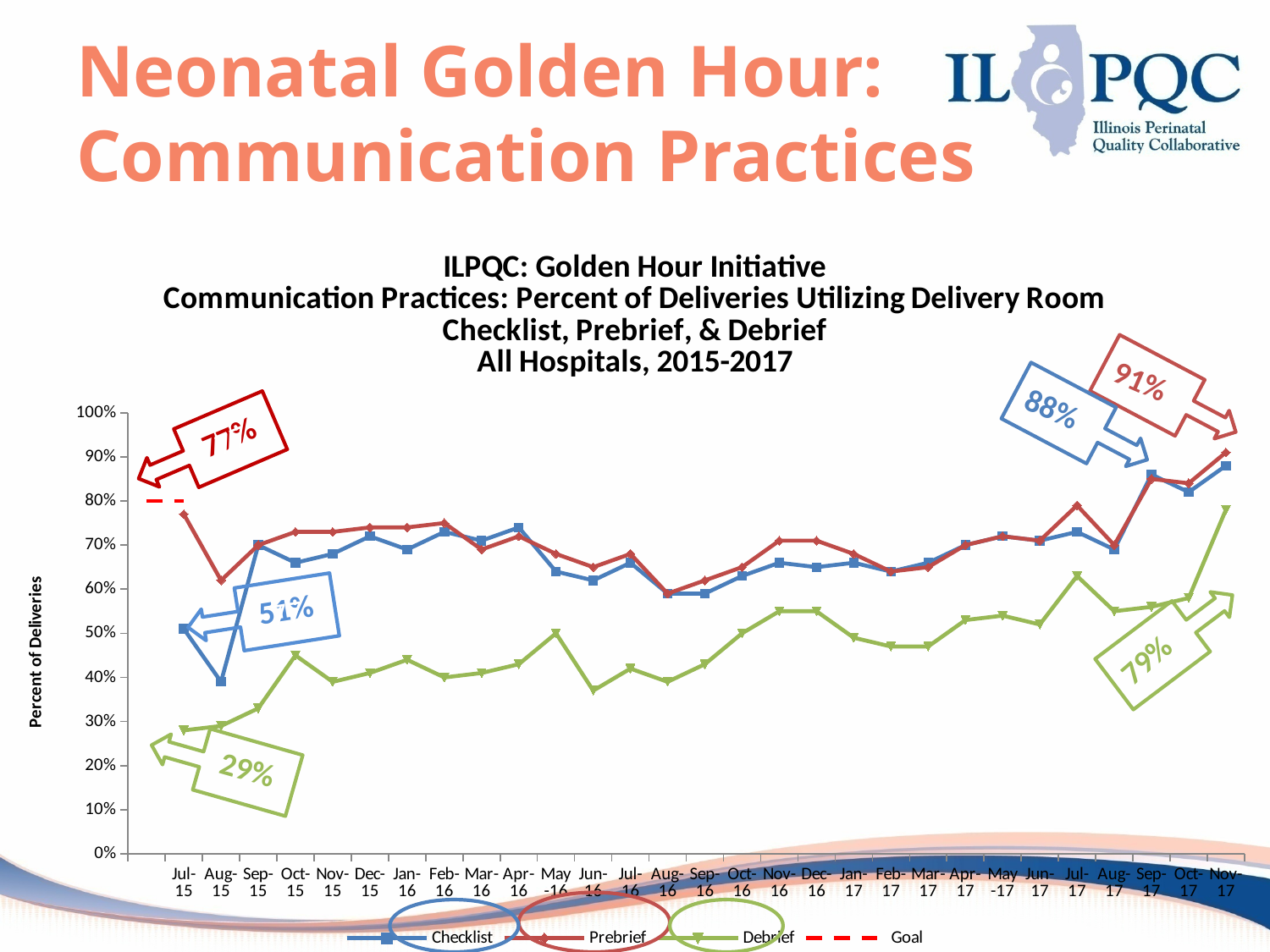
Is the Debrief value for Aug-15 greater or less than 40%? less What is the Debrief value for Jul-15? 29% By how many percentage points did the Checklist value increase from Jul-15 to Nov-17? 37 What is the Prebrief value for Nov-17? 91% What is the Debrief value for Nov-17? 79% How many series does the chart legend list? 4 What is the Checklist value for Nov-17? 88% Does the Debrief series generally rise or fall from Jul-15 to Nov-17? Rise Which series has the lowest value at Jul-15? Debrief What is the Checklist value for Jul-15? 51% What is the Prebrief value for Jul-15? 77% What kind of chart is shown on the slide? Line chart